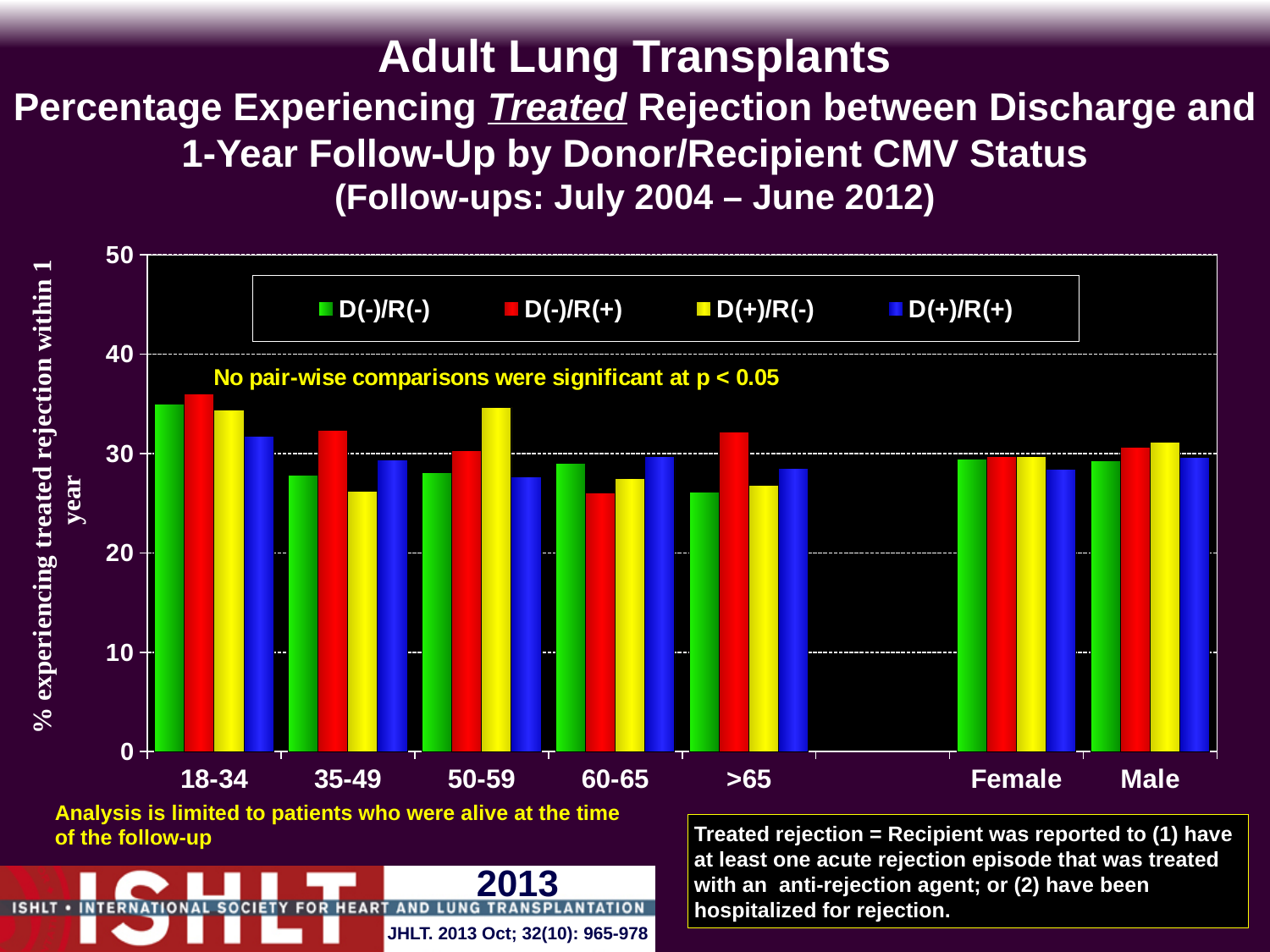
Is the value for D(+)/R(-) in the 50-59 age group greater or less than 30? greater What does the annotation inside the chart say about pair-wise comparisons? No pair-wise comparisons were significant at p < 0.05 Is the value for D(-)/R(+) in the >65 age group greater or less than 40? less What kind of chart is shown on the slide? bar chart How many series does the legend list? 4 Which CMV status group has the highest value in the >65 age group? D(-)/R(+) How many categories are shown along the x axis? 7 Which CMV status group has the highest value in the 50-59 age group? D(+)/R(-) Is the value for D(-)/R(-) in the 18-34 age group greater or less than 30? greater Which is larger: D(-)/R(+) in the 18-34 age group or D(-)/R(-) in the 35-49 age group? D(-)/R(+) in the 18-34 age group